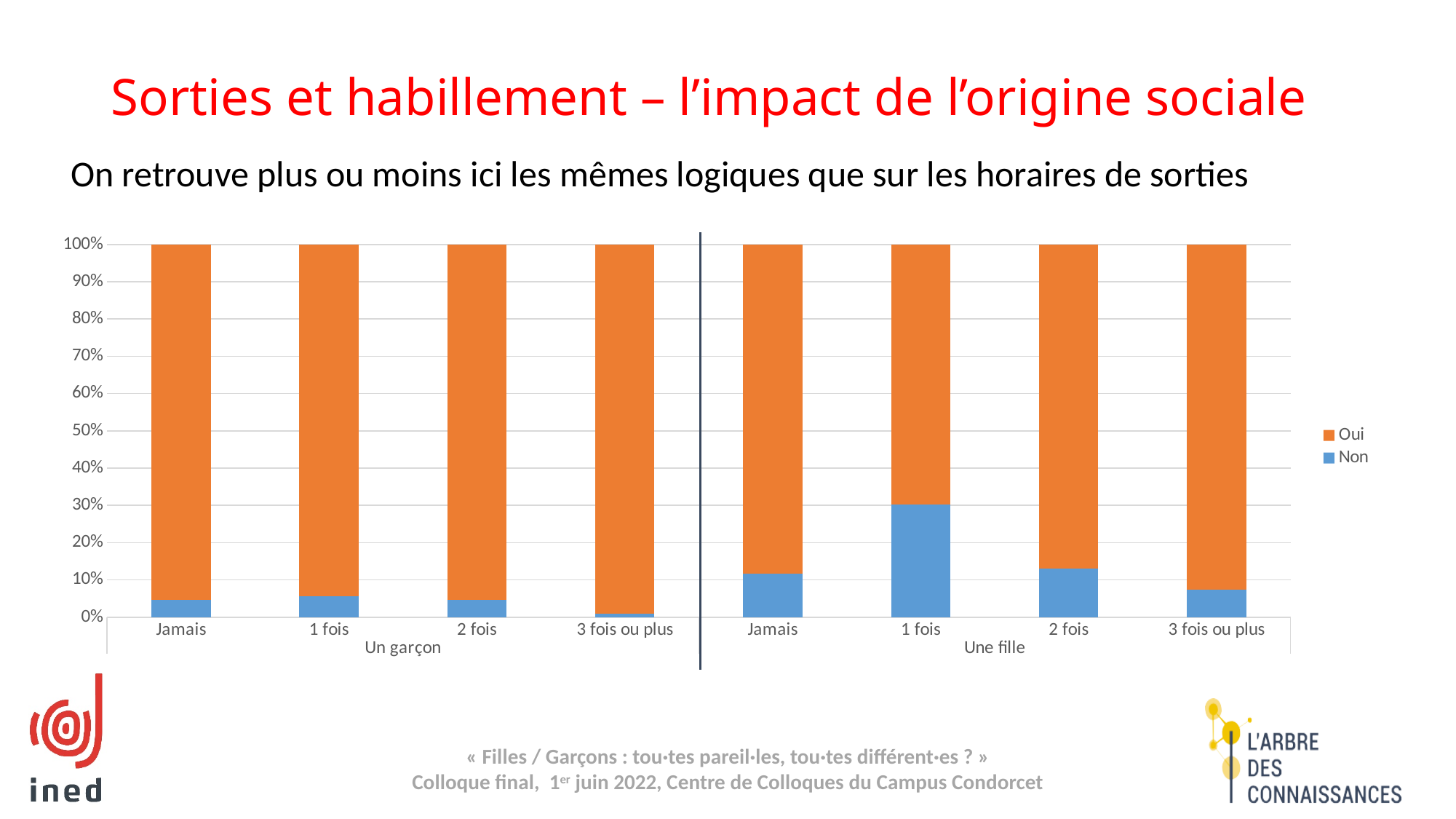
What is the total height of each stacked bar? 100% Which bar has the largest 'Non' share? 1 fois (Une fille) Is the 'Non' share for '1 fois' in the 'Une fille' group greater or less than 20%? greater How many bars are plotted in the chart in total? 8 Which bar has the smallest 'Non' share? 3 fois ou plus (Un garçon) What are the two groups labelled on the x axis? Un garçon and Une fille Is the 'Non' share for '1 fois' in the 'Un garçon' group greater or less than 10%? less What kind of chart is shown on the slide? Stacked bar chart Is the 'Oui' share for '1 fois' in the 'Une fille' group greater or less than 60%? greater Which has the larger 'Non' share: '2 fois' for 'Un garçon' or '2 fois' for 'Une fille'? 2 fois for Une fille What are the two series named in the legend? Oui and Non How many series does the chart legend list? 2